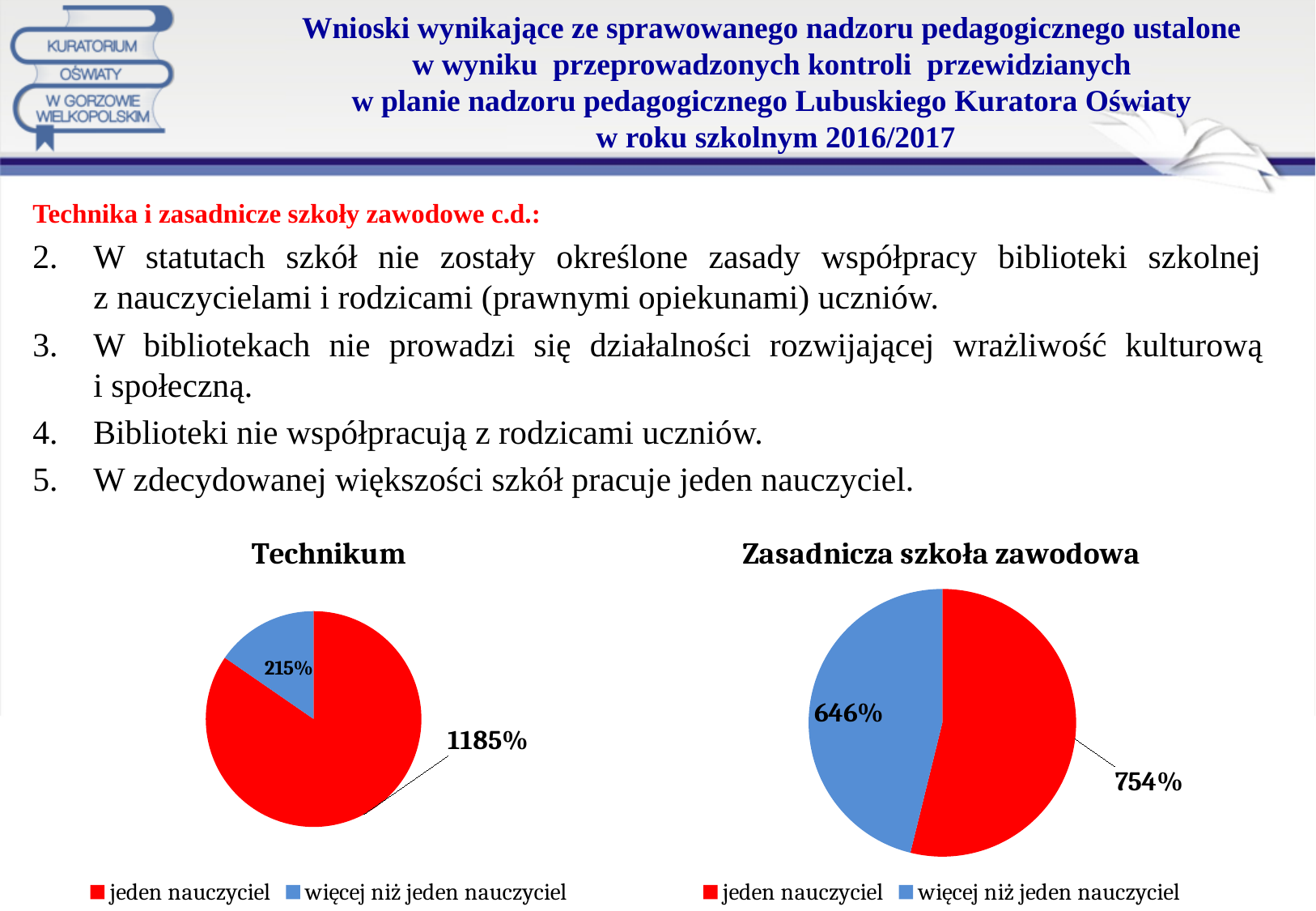
In the Zasadnicza szkoła zawodowa chart, which category has the smallest slice? więcej niż jeden nauczyciel What type of chart is the Technikum chart? pie chart In the Technikum chart, what value is shown for the 'więcej niż jeden nauczyciel' slice? 215% In the Zasadnicza szkoła zawodowa chart, what value is shown for the 'więcej niż jeden nauczyciel' slice? 646% In the Technikum chart, what value is shown for the 'jeden nauczyciel' slice? 1185% In the Technikum chart, what colour is the 'więcej niż jeden nauczyciel' slice? blue In the Technikum chart, which category has the largest slice? jeden nauczyciel In the Zasadnicza szkoła zawodowa chart, what value is shown for the 'jeden nauczyciel' slice? 754% How many categories does the Zasadnicza szkoła zawodowa chart show? 2 In the Zasadnicza szkoła zawodowa chart, which is larger: 'jeden nauczyciel' or 'więcej niż jeden nauczyciel'? jeden nauczyciel